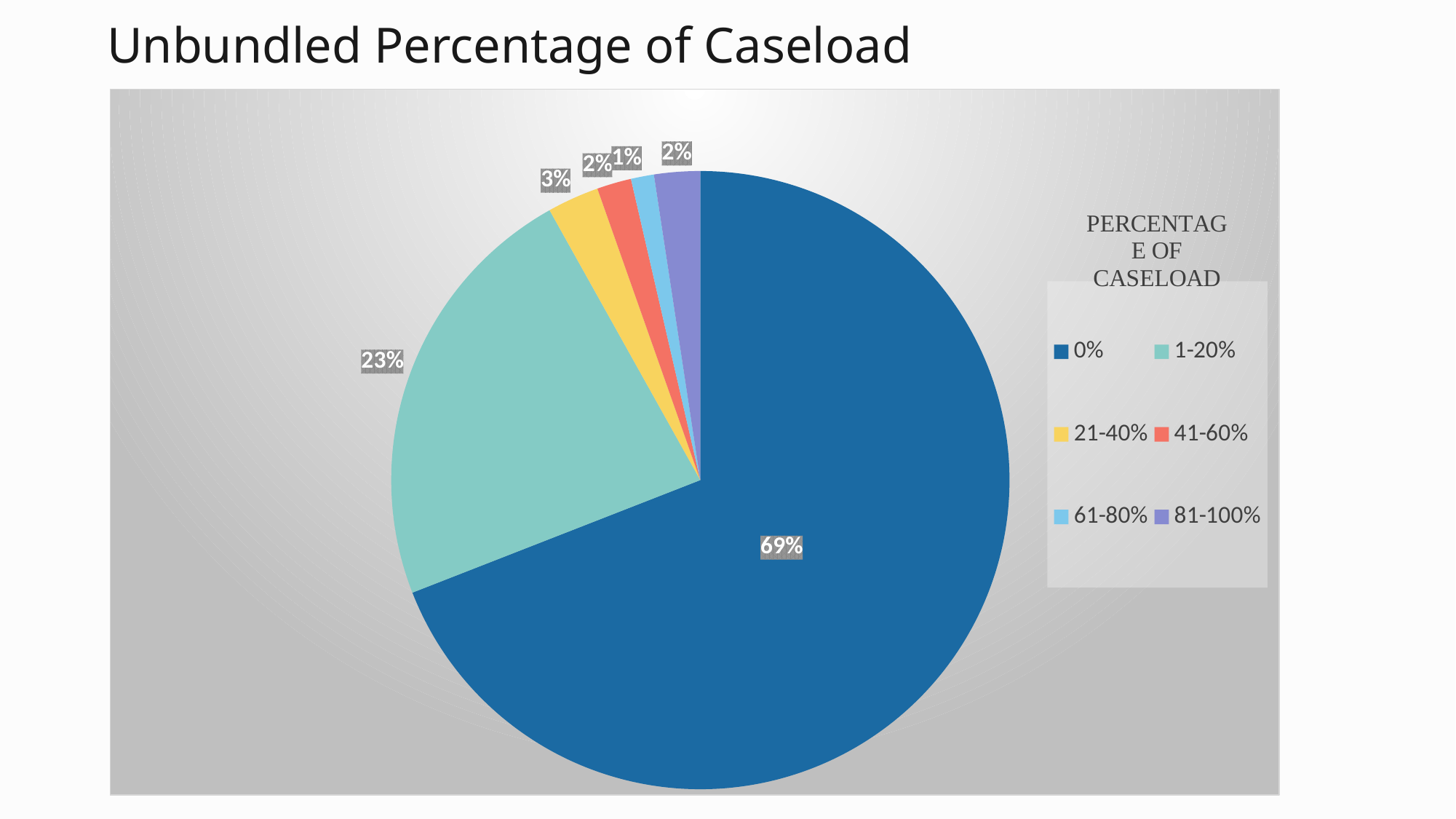
What kind of chart is shown on the slide? Pie chart What is the difference between the 0% slice and the 1-20% slice? 46% Which category has the largest slice of the pie? 0% Which is larger, the 21-40% slice or the 61-80% slice? 21-40% What is the value shown for the 21-40% slice? 3% What share of the pie does the 1-20% category represent? 23% How many categories does the pie chart have? 6 What is the title of the chart? Unbundled Percentage of Caseload What is the value shown for the 61-80% slice? 1% What share of the pie does the 0% category represent? 69% Which category has the smallest slice of the pie? 61-80% What is the value shown for the 81-100% slice? 2%